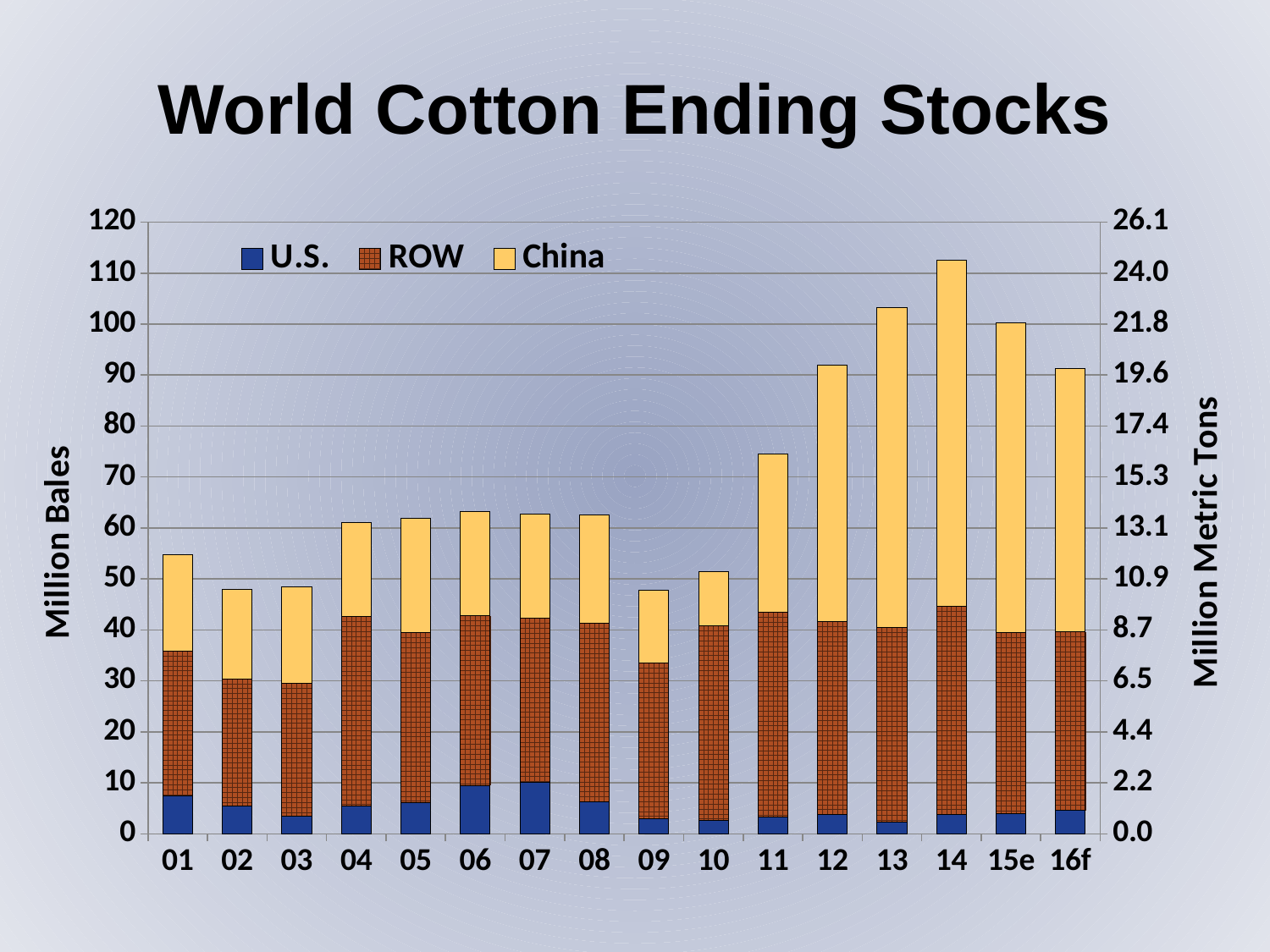
Which has the larger total ending stocks, 14 or 15e? 14 Is the total ending stocks value for 01 greater or less than 60 million bales? less Is the total ending stocks value for 14 greater or less than 100 million bales? greater What kind of chart is shown on the slide? Stacked bar chart What is the label on the left vertical axis? Million Bales Which year has the highest total ending stocks? 14 How many series does the legend list? 3 Do total ending stocks rise or fall from 10 to 14? rise Is the total ending stocks value for 11 greater or less than 70 million bales? greater How many years (categories) are shown along the x axis? 16 What is the title of the chart? World Cotton Ending Stocks Which has the larger total ending stocks, 01 or 04? 04